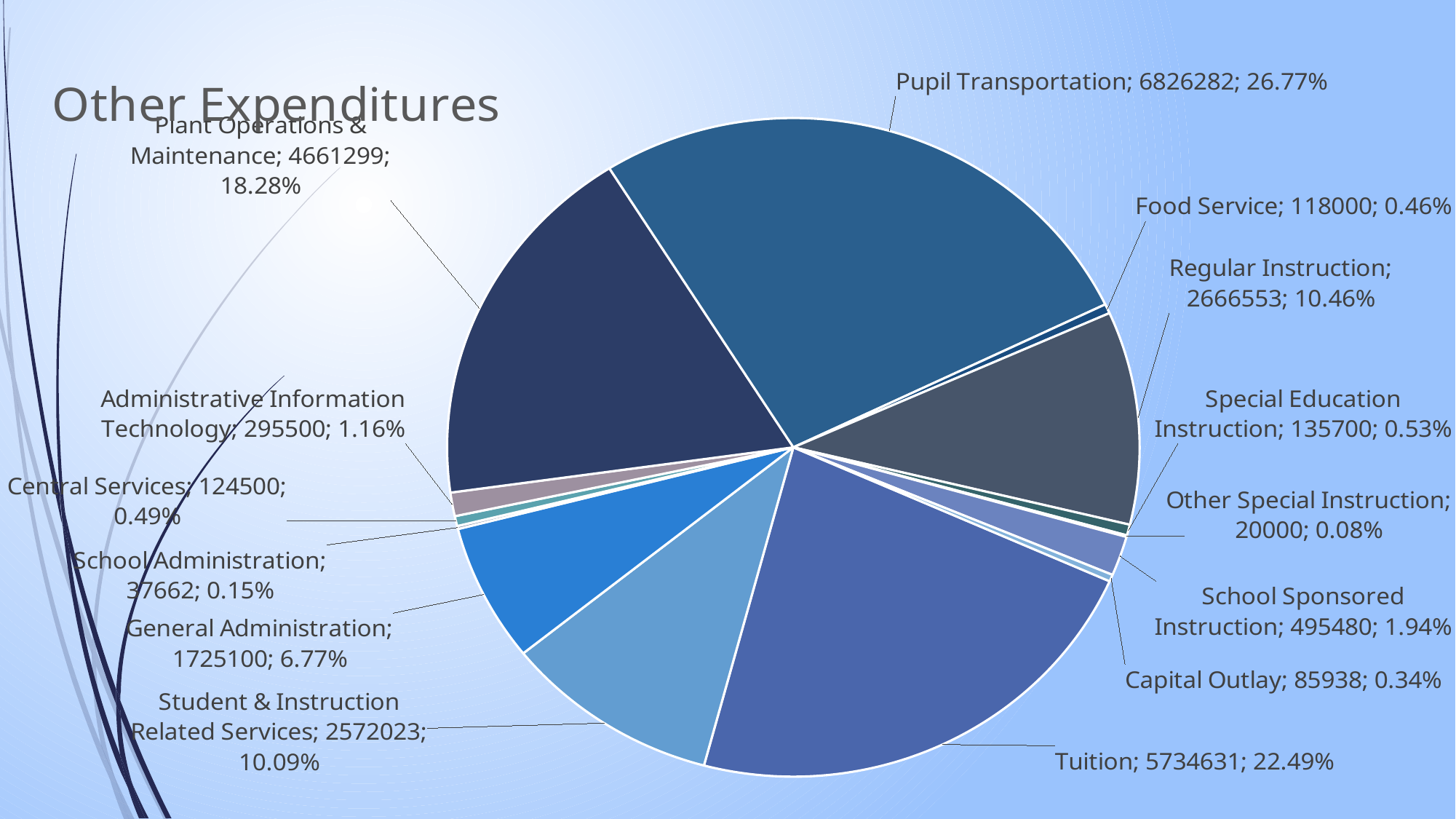
Which is larger, Regular Instruction or Student & Instruction Related Services? Regular Instruction What is the value for Plant Operations & Maintenance? 4661299 How many slices does the pie chart have? 14 What share of the pie does Tuition represent? 22.49% What is the difference between the values for Central Services and Food Service? 6500 What is the difference between the values for Pupil Transportation and Tuition? 1091651 Which category has the largest slice? Pupil Transportation Which category has the smallest slice? Other Special Instruction What type of chart is shown on the slide? pie chart What share of the pie does General Administration represent? 6.77% What is the title of the chart? Other Expenditures What is the value for Pupil Transportation? 6826282